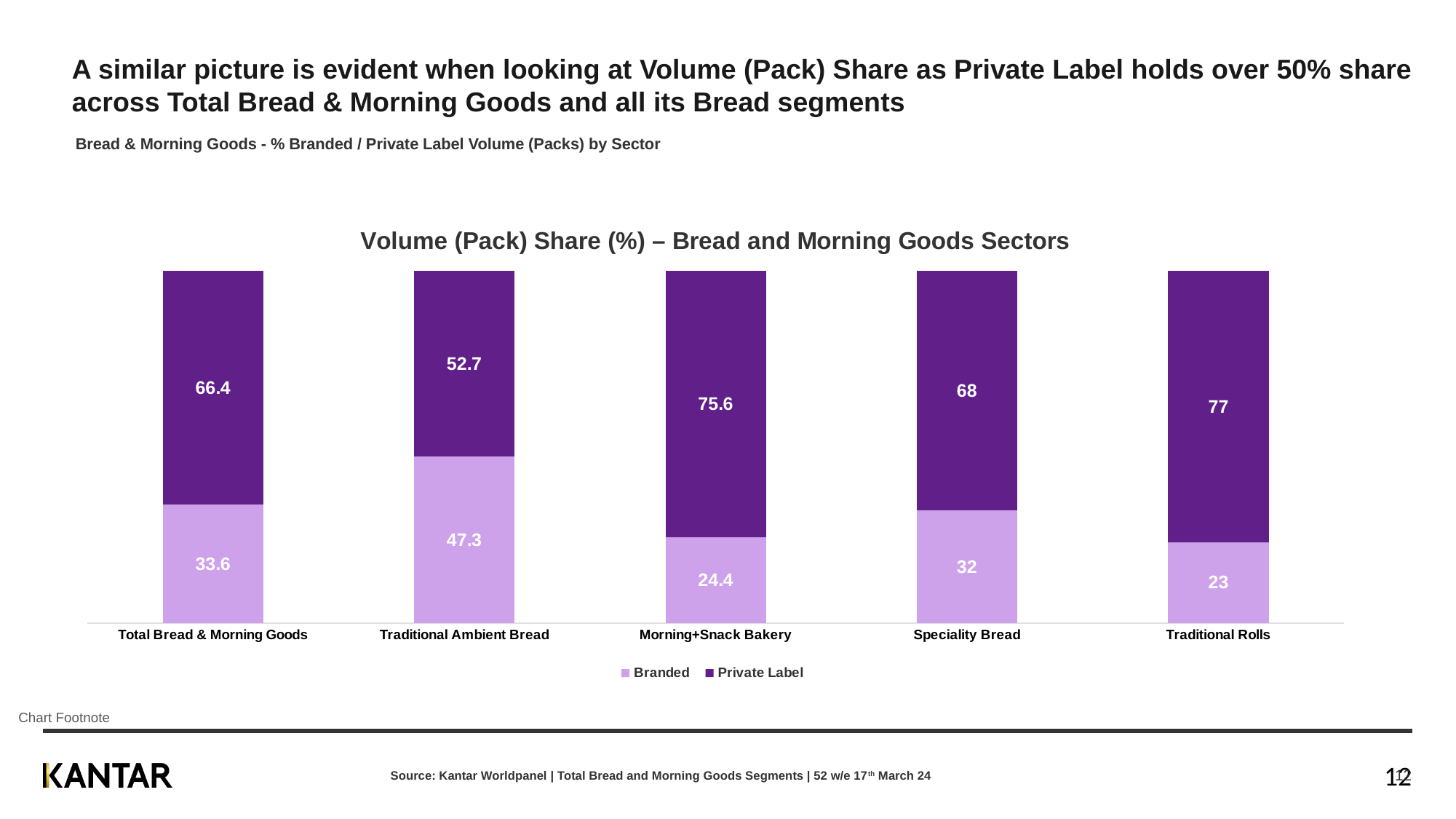
What is the Private Label value for Traditional Rolls? 77 Which sector has the lowest Branded value? Traditional Rolls What is the Branded value for Total Bread & Morning Goods? 33.6 How many series does the legend list? 2 What is the Private Label value for Morning+Snack Bakery? 75.6 What type of chart is shown? Stacked bar chart How many sectors are shown on the x axis? 5 Which is larger, the Branded value for Traditional Ambient Bread or the Branded value for Speciality Bread? Traditional Ambient Bread What is the Branded value for Traditional Ambient Bread? 47.3 Which sector has the highest Private Label value? Traditional Rolls What is the difference between the Private Label and Branded values for Speciality Bread? 36 What is the total of the stacked bar for Total Bread & Morning Goods? 100